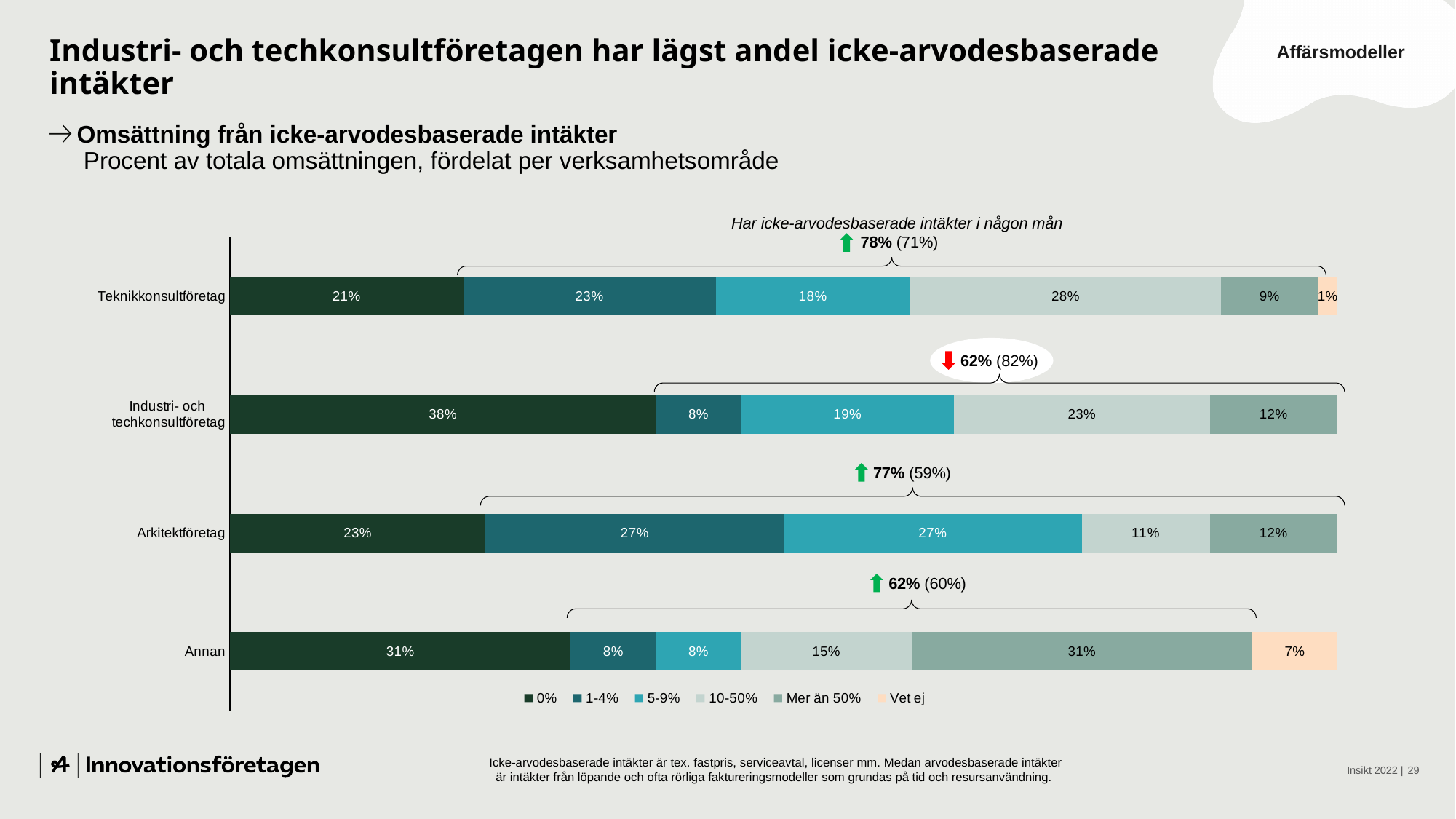
What is the value of the 'Vet ej' segment for Teknikkonsultföretag? 1% What kind of chart is shown on the slide? Stacked bar chart Which category has the smallest '10-50%' segment? Arkitektföretag How many categories (verksamhetsområden) are plotted on the chart? 4 What is the value of the 'Mer än 50%' segment for Annan? 31% Which category has the largest '0%' segment? Industri- och techkonsultföretag What is the value of the '10-50%' segment for Teknikkonsultföretag? 28% How many series does the legend list? 6 Which is larger: the '5-9%' segment for Arkitektföretag or the '5-9%' segment for Teknikkonsultföretag? Arkitektföretag What share of Industri- och techkonsultföretag is annotated as having non-fee-based income to some extent (Har icke-arvodesbaserade intäkter i någon mån)? 62% (82%) What is the value of the '0%' segment for Industri- och techkonsultföretag? 38% What is the difference between the '1-4%' segment for Arkitektföretag and the '1-4%' segment for Annan? 19 percentage points